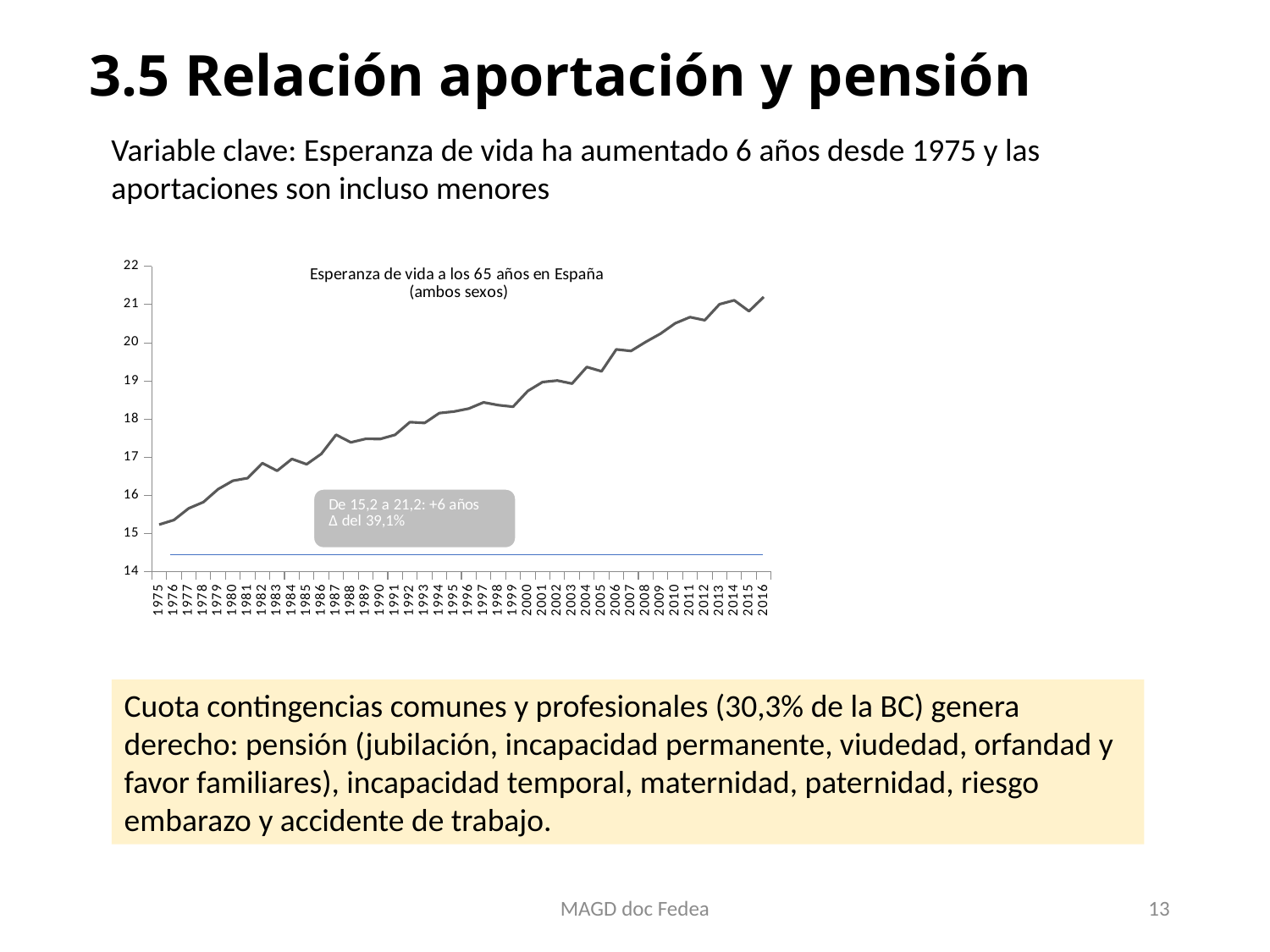
What is the title of the chart? Esperanza de vida a los 65 años en España (ambos sexos) Which year has the highest value in the chart? 2016 What percentage increase does the annotation on the chart give? 39,1% What kind of chart is shown on the slide? line chart Which year has the lowest value in the chart? 1975 Is the value for 1995 greater or less than 19? less According to the annotation on the chart, what was the life expectancy at 65 in 2016? 21,2 According to the annotation on the chart, what was the life expectancy at 65 in 1975? 15,2 By how many years did life expectancy at 65 increase between 1975 and 2016, according to the annotation? +6 años How many years (data points) are plotted on the x axis? 42 Do the values in the chart generally rise or fall from 1975 to 2016? rise Is the value for 2010 greater or less than 20? greater